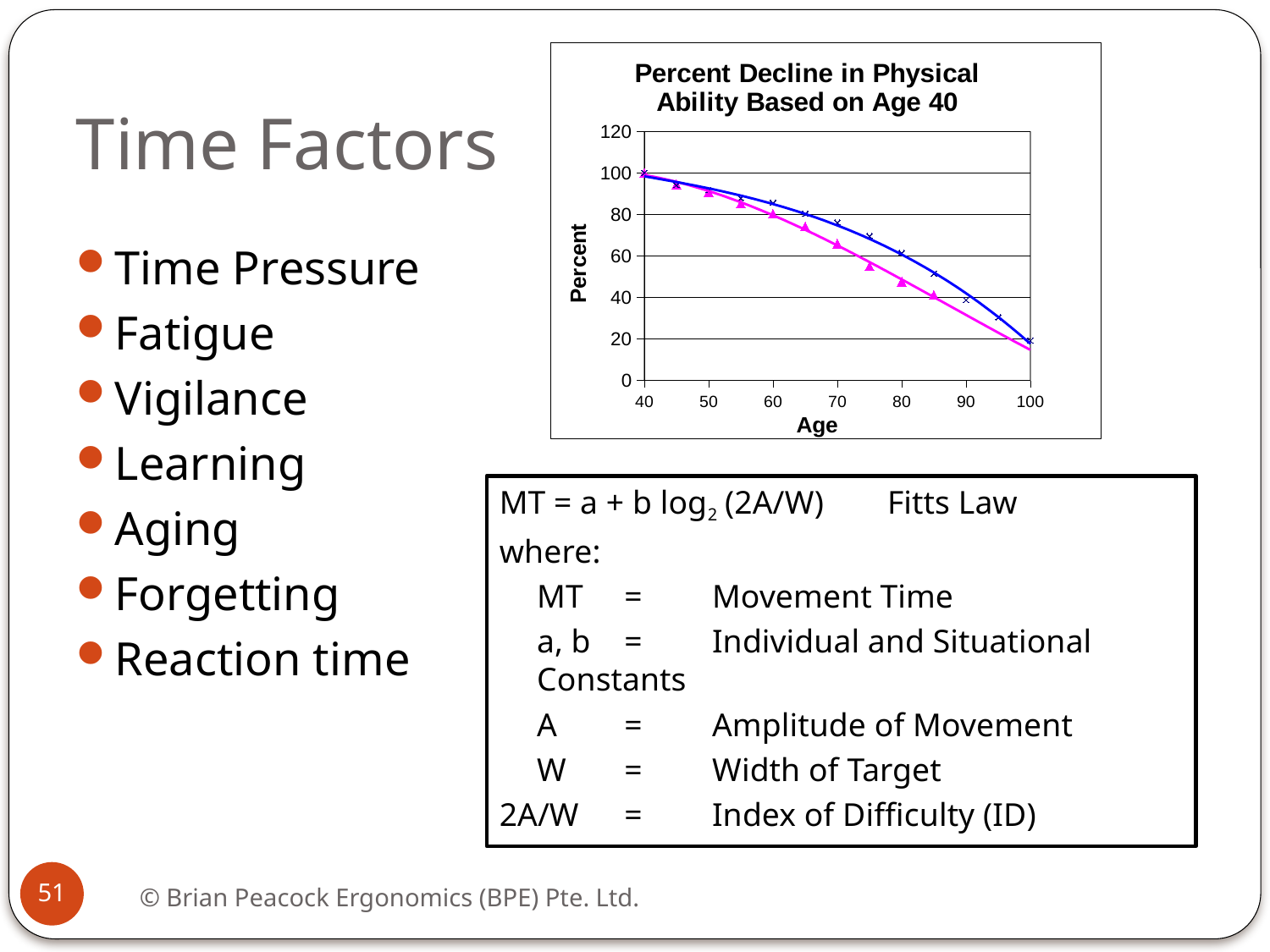
Is the value of the blue line (x markers) at age 70 greater or less than 60? greater What is the value of both lines at age 40? 100 Do the plotted values rise or fall as age increases from 40 to 100? fall At age 80, which line has the higher value, the blue line with x markers or the magenta line with triangle markers? the blue line with x markers How many lines are plotted on the chart? 2 What is the label of the x axis of the chart? Age At which age do the lines reach their lowest value? 100 At which age do the lines reach their highest value? 40 Is the value of the magenta line (triangle markers) at age 80 greater or less than 60? less What is the title of the chart? Percent Decline in Physical Ability Based on Age 40 What kind of chart is shown on the slide? line chart